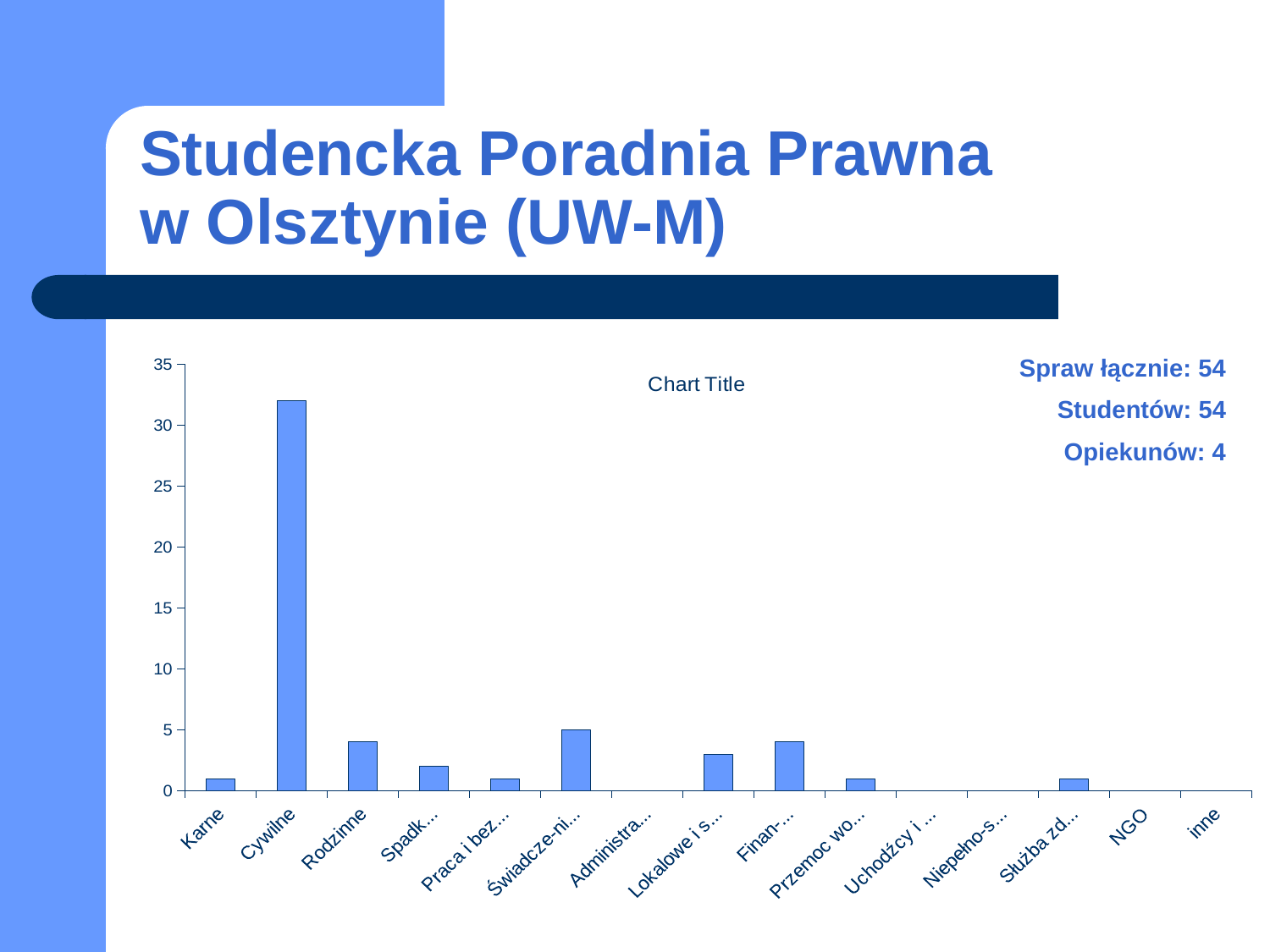
Is the value for Rodzinne greater or less than 5? less Which category has the highest value in the chart? Cywilne Which is larger, the value for Cywilne or the value for Rodzinne? Cywilne Is the value for Cywilne greater or less than 35? less Is the value for Cywilne greater or less than 30? greater What is the value for NGO? 0 What is the highest value shown on the vertical axis of the chart? 35 How many categories are shown on the x axis of the chart? 15 What kind of chart is shown on the slide? bar chart What is the title shown on the chart? Chart Title Which is larger, the value for Rodzinne or the value for Karne? Rodzinne